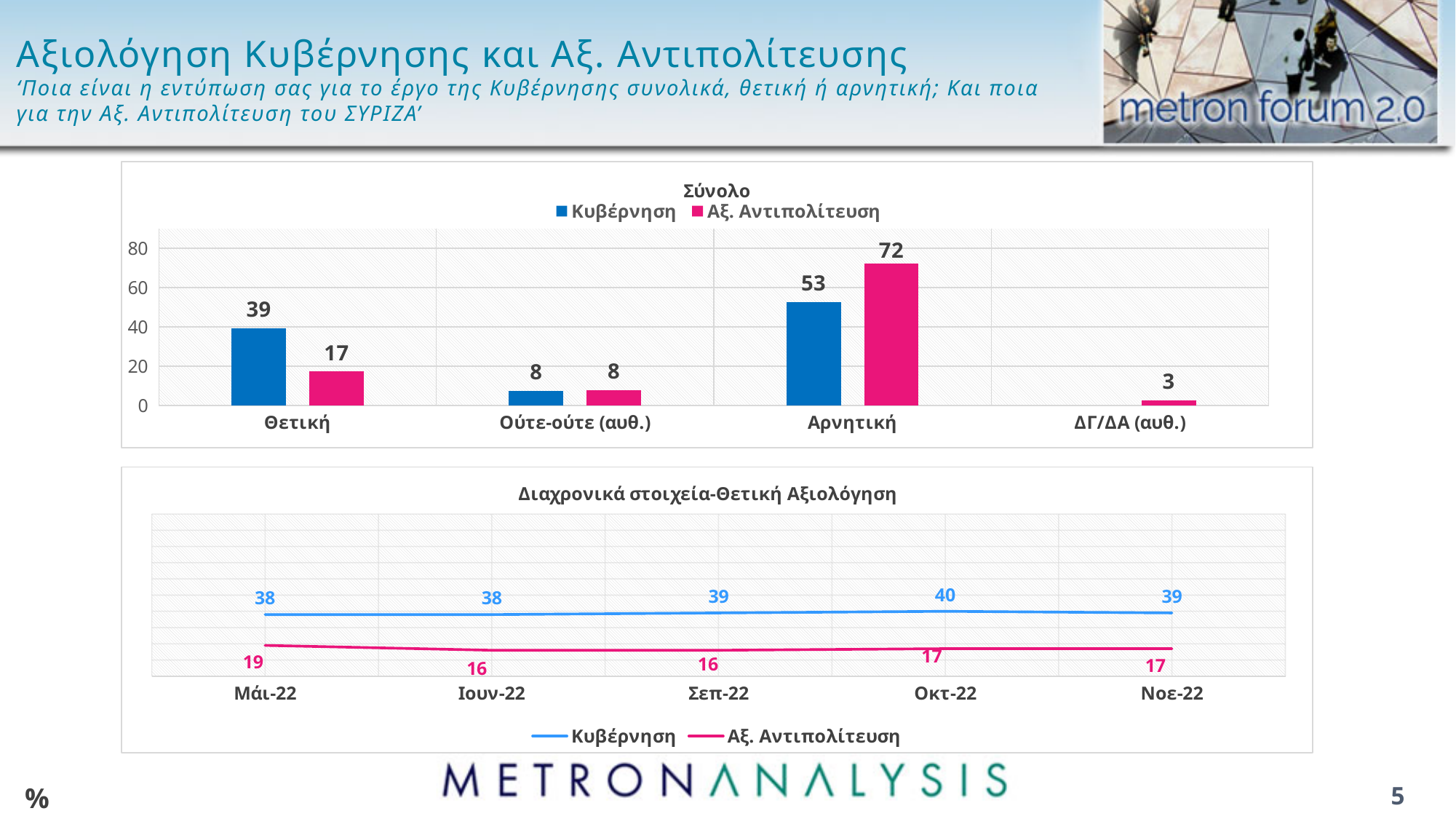
In the 'Διαχρονικά στοιχεία-Θετική Αξιολόγηση' chart, in which period is the Αξ. Αντιπολίτευση value highest? Μάι-22 In the 'Διαχρονικά στοιχεία-Θετική Αξιολόγηση' chart, how many series does the legend list? 2 In the 'Σύνολο' chart, what is the value for Κυβέρνηση in the Θετική category? 39 In the 'Διαχρονικά στοιχεία-Θετική Αξιολόγηση' chart, what is the value for Κυβέρνηση in Οκτ-22? 40 In the 'Σύνολο' chart, what is the value for Αξ. Αντιπολίτευση in the Αρνητική category? 72 In the 'Διαχρονικά στοιχεία-Θετική Αξιολόγηση' chart, what is the value for Αξ. Αντιπολίτευση in Μάι-22? 19 In the 'Σύνολο' chart, what is the difference between Αξ. Αντιπολίτευση and Κυβέρνηση in the Αρνητική category? 19 In the 'Σύνολο' chart, how many categories are shown on the x axis? 4 In the 'Σύνολο' chart, which category has the highest value for Κυβέρνηση? Αρνητική In the 'Διαχρονικά στοιχεία-Θετική Αξιολόγηση' chart, what is the difference between Κυβέρνηση and Αξ. Αντιπολίτευση in Νοε-22? 22 What type of chart is the 'Σύνολο' chart? bar chart In the 'Σύνολο' chart, which series has the larger value in the Θετική category? Κυβέρνηση